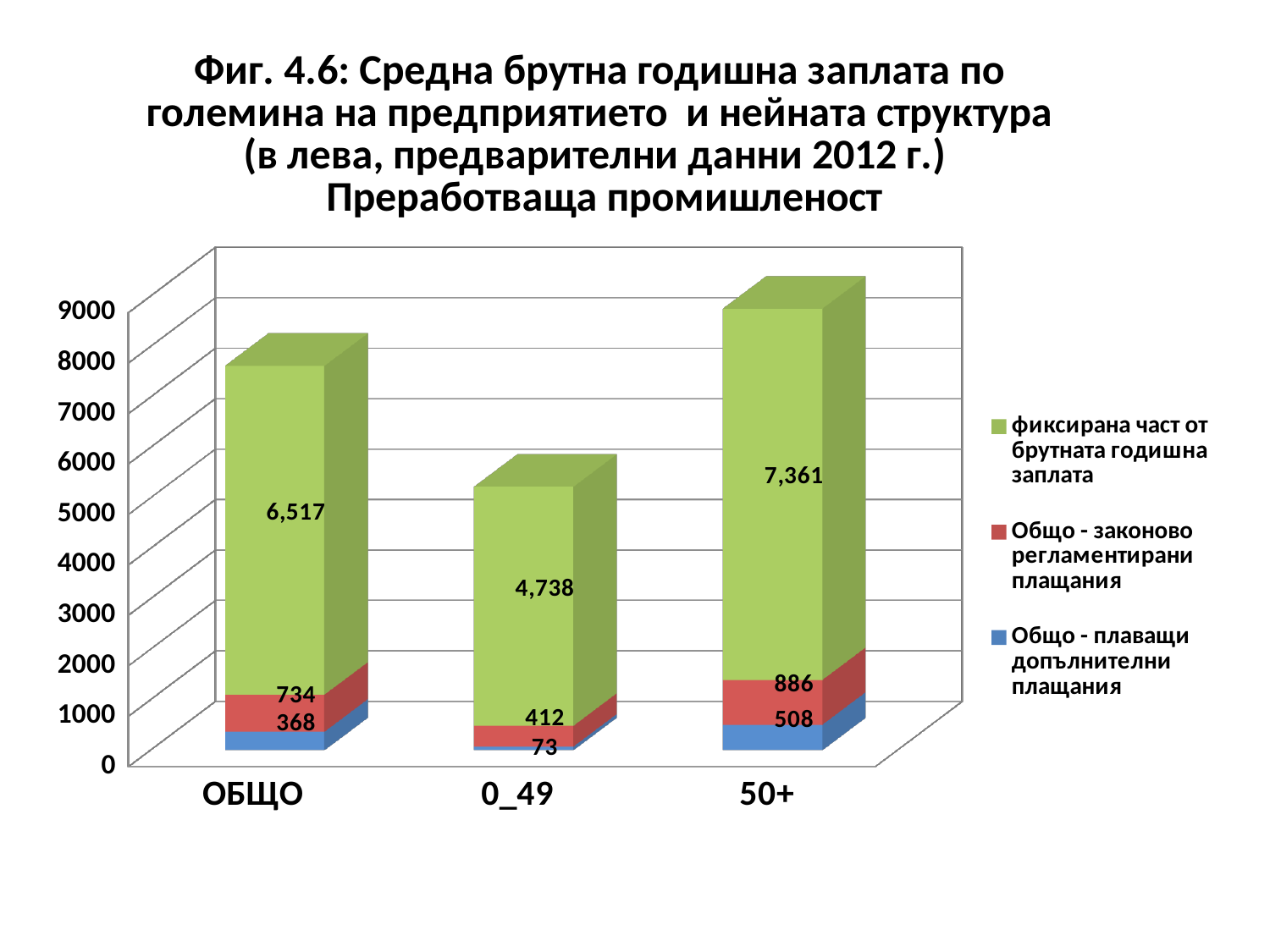
What is the value of Общо - законово регламентирани плащания for 50+? 886 How many series does the legend list? 3 What is the value of the fixed part of the gross annual salary (фиксирана част от брутната годишна заплата) for 0_49? 4,738 Which category has the highest value for фиксирана част от брутната годишна заплата? 50+ How many categories are shown on the x axis? 3 What is the total of the stacked bar for 0_49? 5,223 What is the difference between the fixed part of the gross annual salary for 50+ and for 0_49? 2,623 What is the total of the stacked bar for 50+? 8,755 What type of chart is shown on the slide? stacked bar chart What is the value of Общо - плаващи допълнителни плащания for ОБЩО? 368 Which category has the lowest value for Общо - плаващи допълнителни плащания? 0_49 Which is larger: Общо - законово регламентирани плащания for ОБЩО or for 0_49? ОБЩО